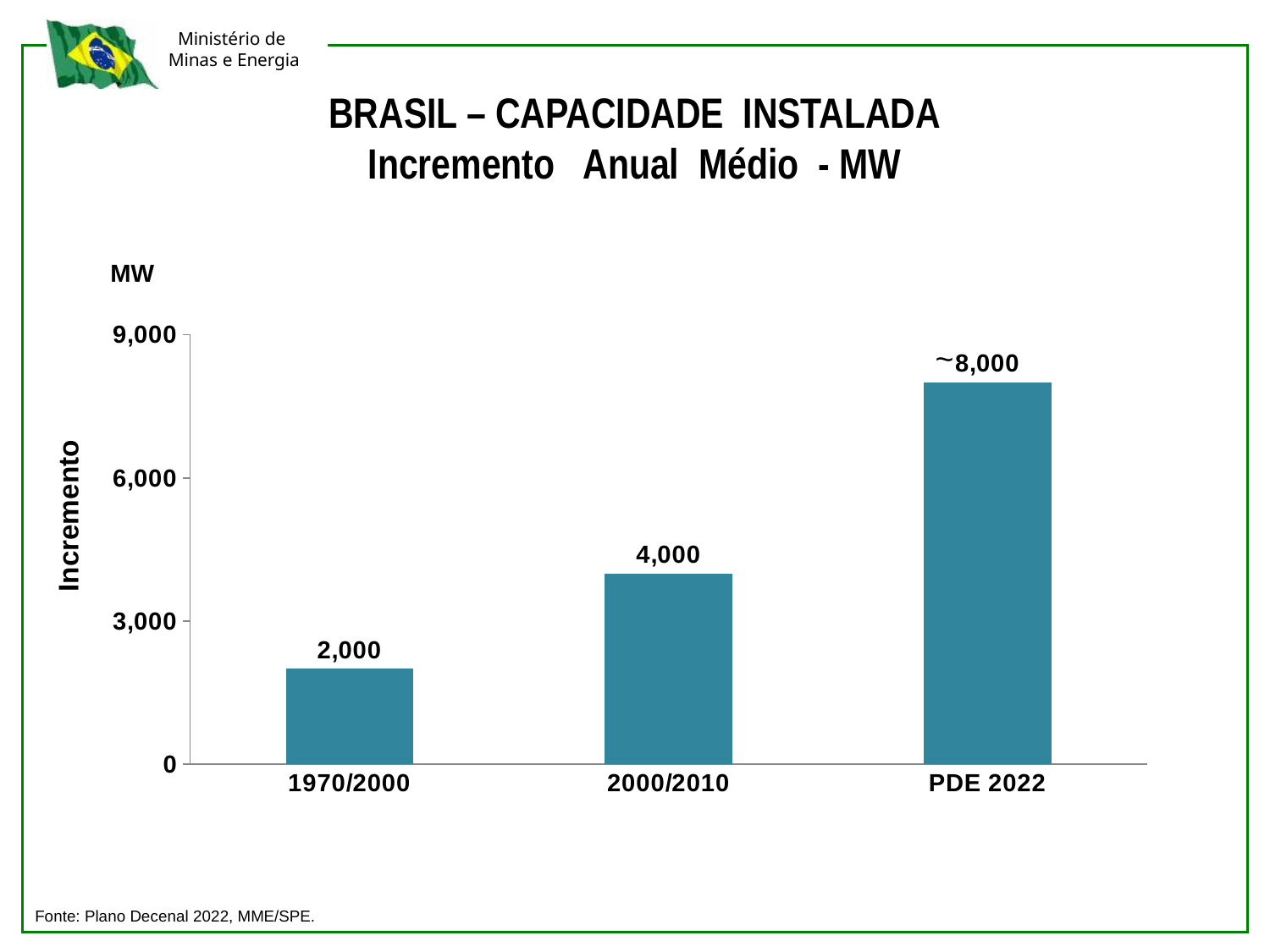
What kind of chart is shown on the slide? bar chart Do the values rise or fall from left to right along the x axis? rise Which category has the lowest value? 1970/2000 Is the value for PDE 2022 greater or less than 6,000? greater How many categories are shown on the x axis? 3 Which is larger, the value for 2000/2010 or the value for 1970/2000? 2000/2010 Which category has the highest value? PDE 2022 What is the value for 2000/2010? 4,000 What is the value for 1970/2000? 2,000 What is the label of the vertical axis? Incremento What is the difference between the values for 2000/2010 and 1970/2000? 2,000 Is the value for 1970/2000 greater or less than 3,000? less